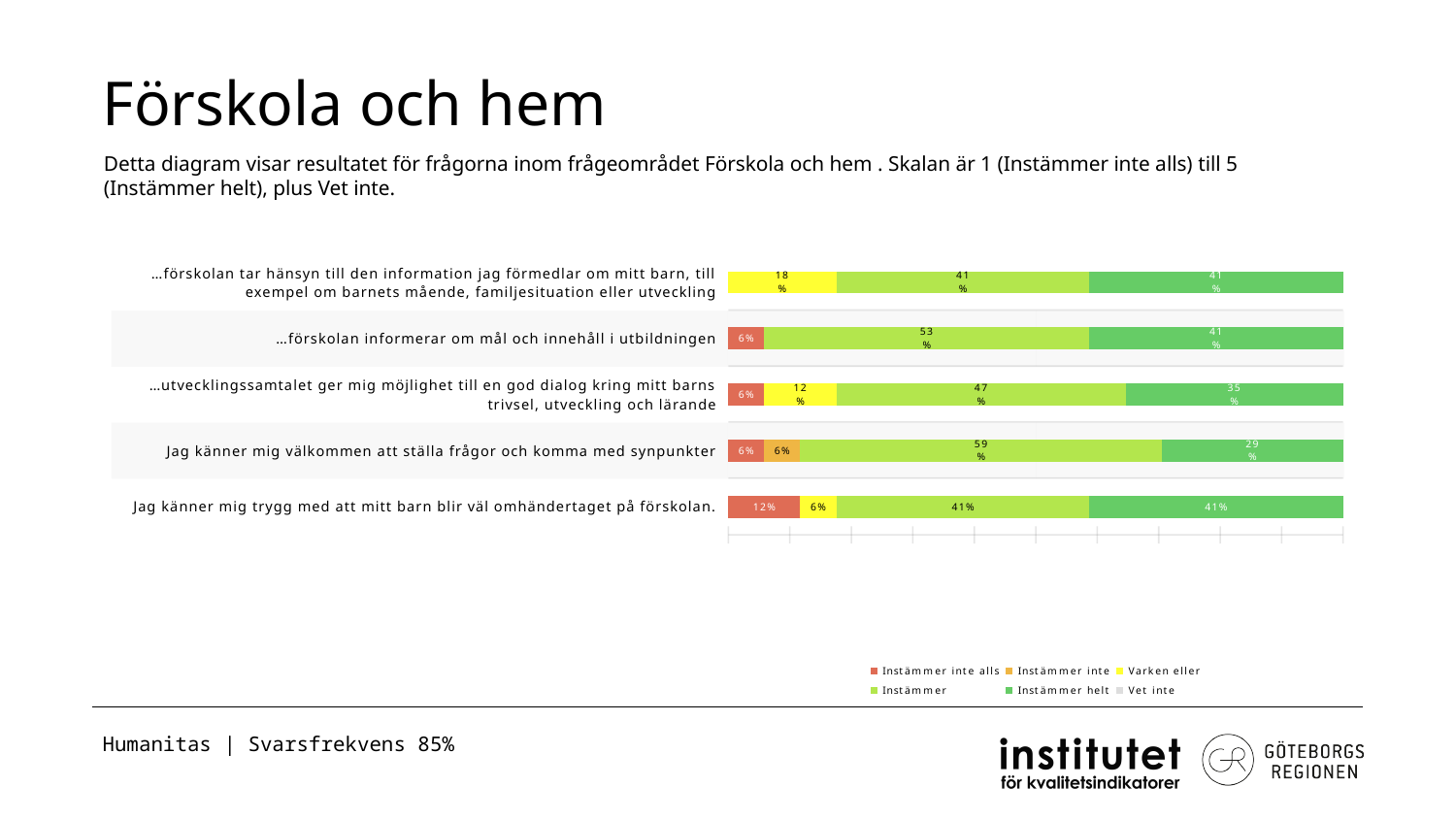
How many statements (categories) are plotted in the chart? 5 What is the difference between the 'Instämmer' value (53%) and the 'Instämmer helt' value (41%) for '…förskolan informerar om mål och innehåll i utbildningen'? 12% Which statement has the highest 'Instämmer' value? Jag känner mig välkommen att ställa frågor och komma med synpunkter What type of chart is shown on the slide? Stacked bar chart What is the 'Instämmer inte alls' value for 'Jag känner mig trygg med att mitt barn blir väl omhändertaget på förskolan'? 12% What is the total of the labelled segments in the bar for 'Jag känner mig välkommen att ställa frågor och komma med synpunkter'? 100% Which statement has the lowest 'Instämmer helt' value? Jag känner mig välkommen att ställa frågor och komma med synpunkter Which is larger for '…utvecklingssamtalet ger mig möjlighet till en god dialog…': the 'Instämmer' value or the 'Instämmer helt' value? Instämmer How many series does the legend list? 6 What is the 'Instämmer helt' value for '…förskolan informerar om mål och innehåll i utbildningen'? 41% What is the 'Varken eller' value for '…förskolan tar hänsyn till den information jag förmedlar om mitt barn…'? 18% What is the 'Instämmer' value for 'Jag känner mig välkommen att ställa frågor och komma med synpunkter'? 59%